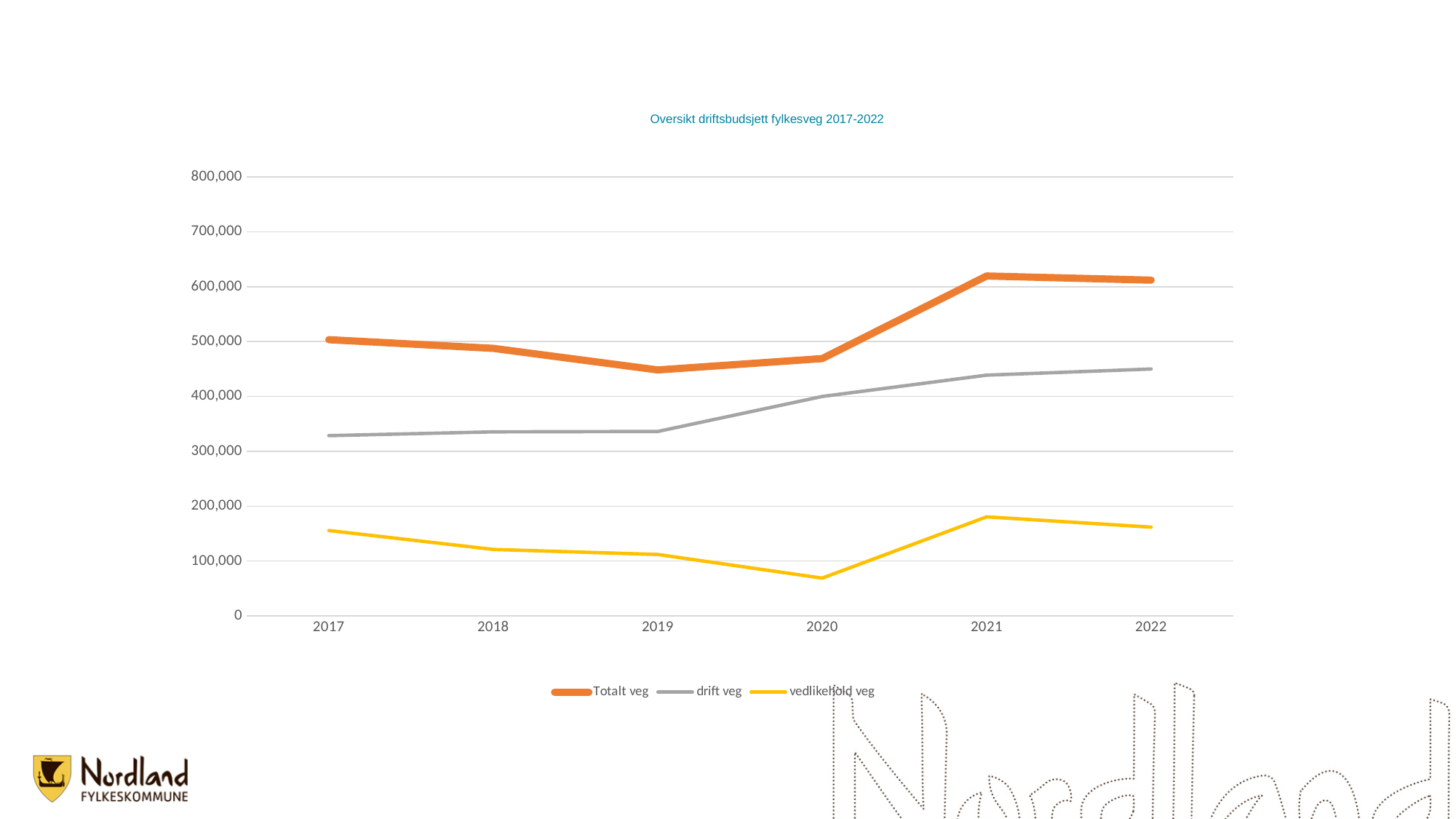
What is the title of the chart? Oversikt driftsbudsjett fylkesveg 2017-2022 How many years are plotted along the x axis? 6 Which is larger in 2022, drift veg or vedlikehold veg? drift veg In which year is the value for vedlikehold veg lowest? 2020 Is the value for Totalt veg in 2021 greater or less than 600,000? greater Is the value for vedlikehold veg in 2020 greater or less than 100,000? less Is the value for drift veg in 2022 greater or less than 500,000? less What kind of chart is shown on the slide? line chart In which year is the value for Totalt veg lowest? 2019 In which year is the value for Totalt veg highest? 2021 How many series does the legend list? 3 In which year is the value for vedlikehold veg highest? 2021